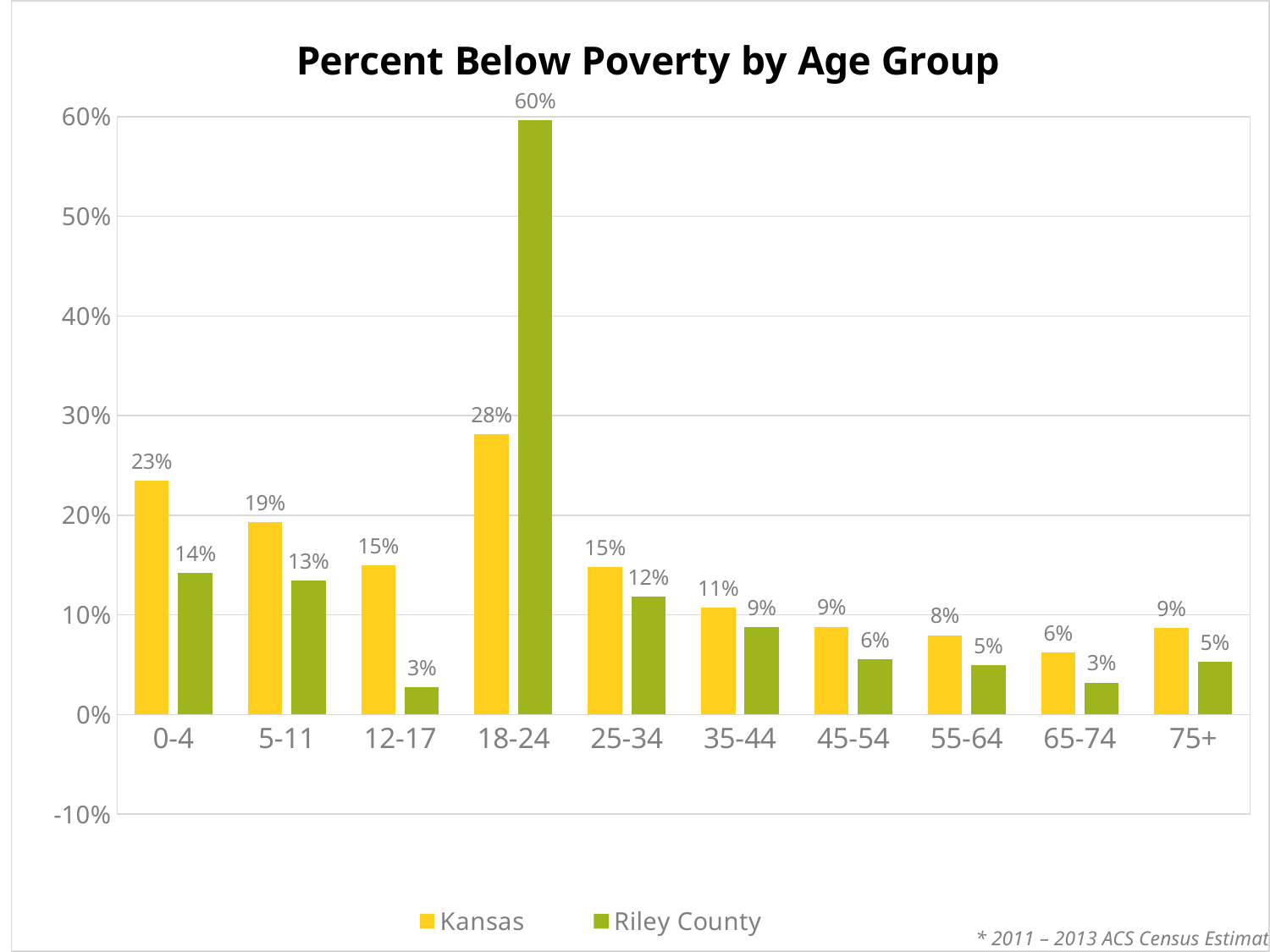
How many series does the legend list? 2 What is the Riley County value for the 12-17 age group? 3% What is the Riley County value for the 18-24 age group? 60% What is the title of the chart? Percent Below Poverty by Age Group What is the Kansas value for the 0-4 age group? 23% For the 5-11 age group, which is larger: the Kansas value or the Riley County value? Kansas What kind of chart is shown on the slide? Bar chart Is the Riley County value for the 18-24 age group greater or less than 50%? greater What is the difference between the Riley County and Kansas values for the 18-24 age group? 32% How many age groups are shown on the x axis? 10 Which age group has the lowest Riley County value? 12-17 and 65-74 (both 3%) Which age group has the highest Riley County value? 18-24